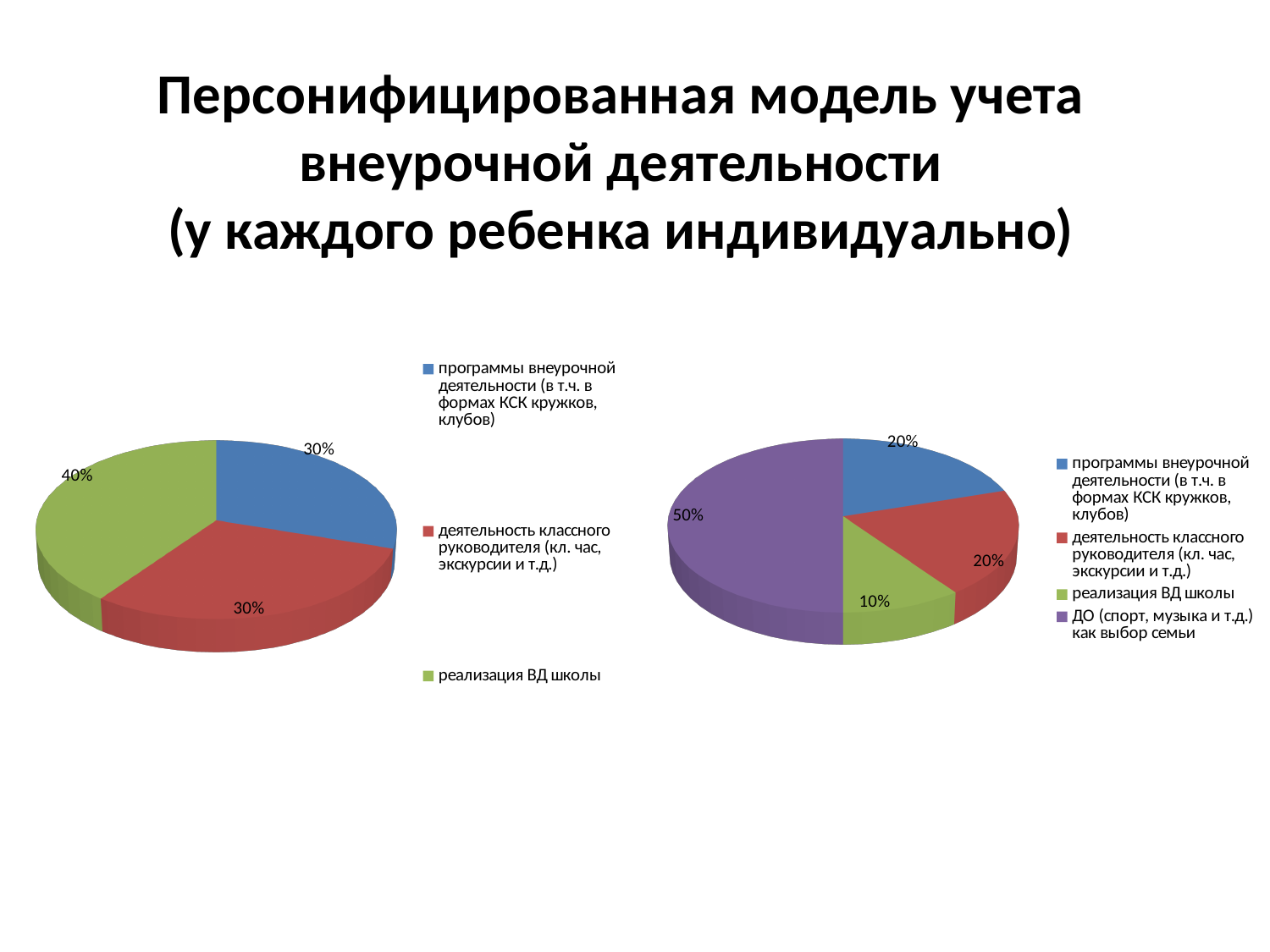
What kind of chart is the left chart? pie chart In the right pie chart, what share does 'реализация ВД школы' have? 10% How many slices does the right pie chart have? 4 In the right pie chart, what colour is the slice for 'ДО (спорт, музыка и т.д.) как выбор семьи'? purple In the left pie chart, which category has the largest share? реализация ВД школы How many slices does the left pie chart have? 3 In the right pie chart, what share does 'ДО (спорт, музыка и т.д.) как выбор семьи' have? 50% In the right pie chart, which category has the largest share? ДО (спорт, музыка и т.д.) как выбор семьи In the left pie chart, what share does 'реализация ВД школы' have? 40% In the right pie chart, which category has the smallest share? реализация ВД школы In the left pie chart, what share does 'деятельность классного руководителя (кл. час, экскурсии и т.д.)' have? 30% In the right pie chart, what is the difference between the share of 'ДО (спорт, музыка и т.д.) как выбор семьи' and the share of 'реализация ВД школы'? 40%